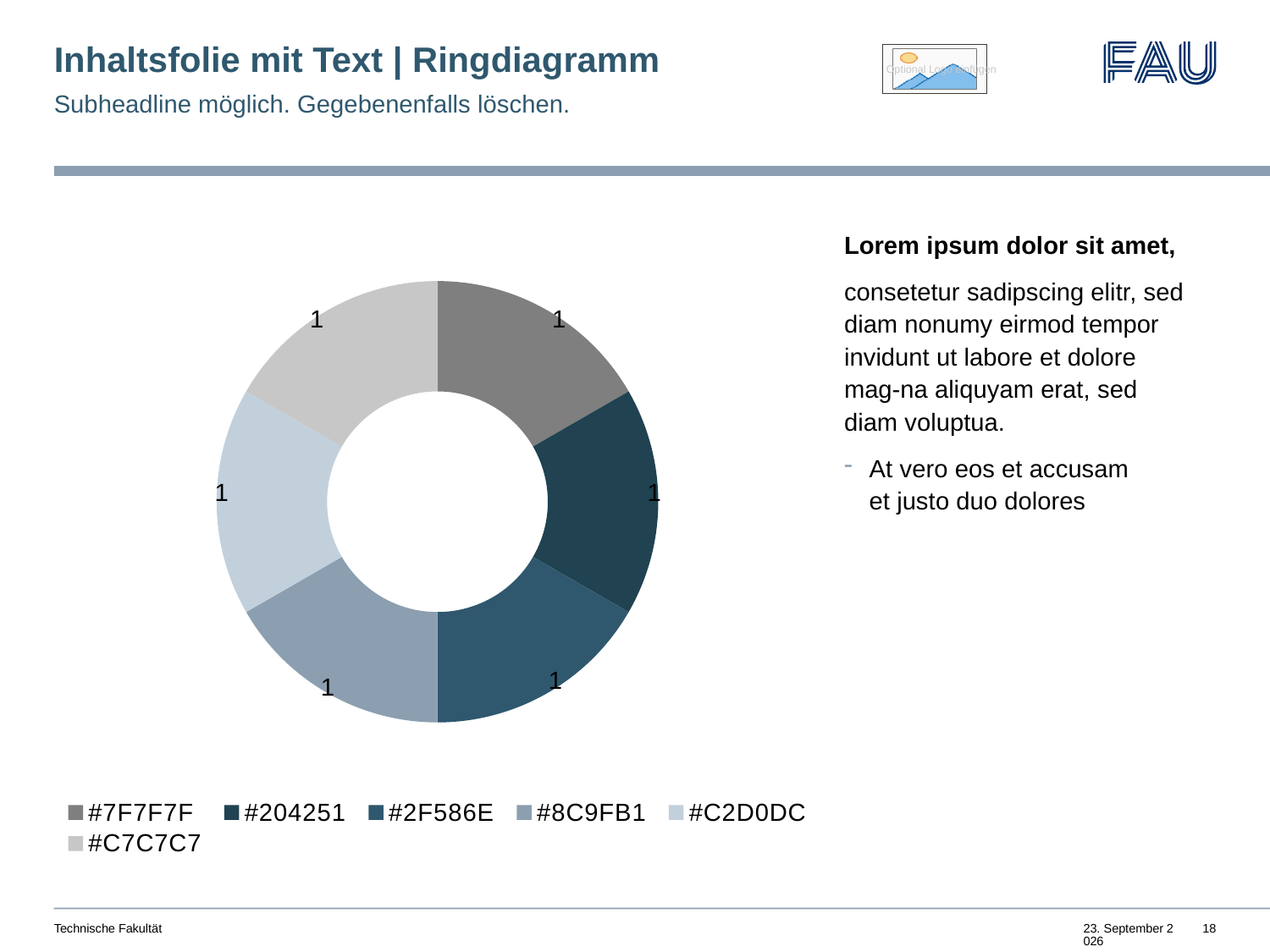
What is the difference between the values of the #2F586E slice and the #C2D0DC slice? 0 What kind of chart is shown on the slide? doughnut chart What is the value of the slice labelled #7F7F7F in the doughnut chart? 1 Which legend entry is listed first in the doughnut chart's legend? #7F7F7F What is the value of the slice labelled #8C9FB1 in the doughnut chart? 1 How many entries does the legend of the doughnut chart list? 6 What is the value of the slice labelled #204251 in the doughnut chart? 1 What is the value of the slice labelled #C7C7C7 in the doughnut chart? 1 How many slices does the doughnut chart have? 6 Which legend entry is listed last in the doughnut chart's legend? #C7C7C7 Is the value of the #204251 slice larger than, smaller than, or equal to the value of the #C2D0DC slice? equal What is the total of all slice values in the doughnut chart? 6